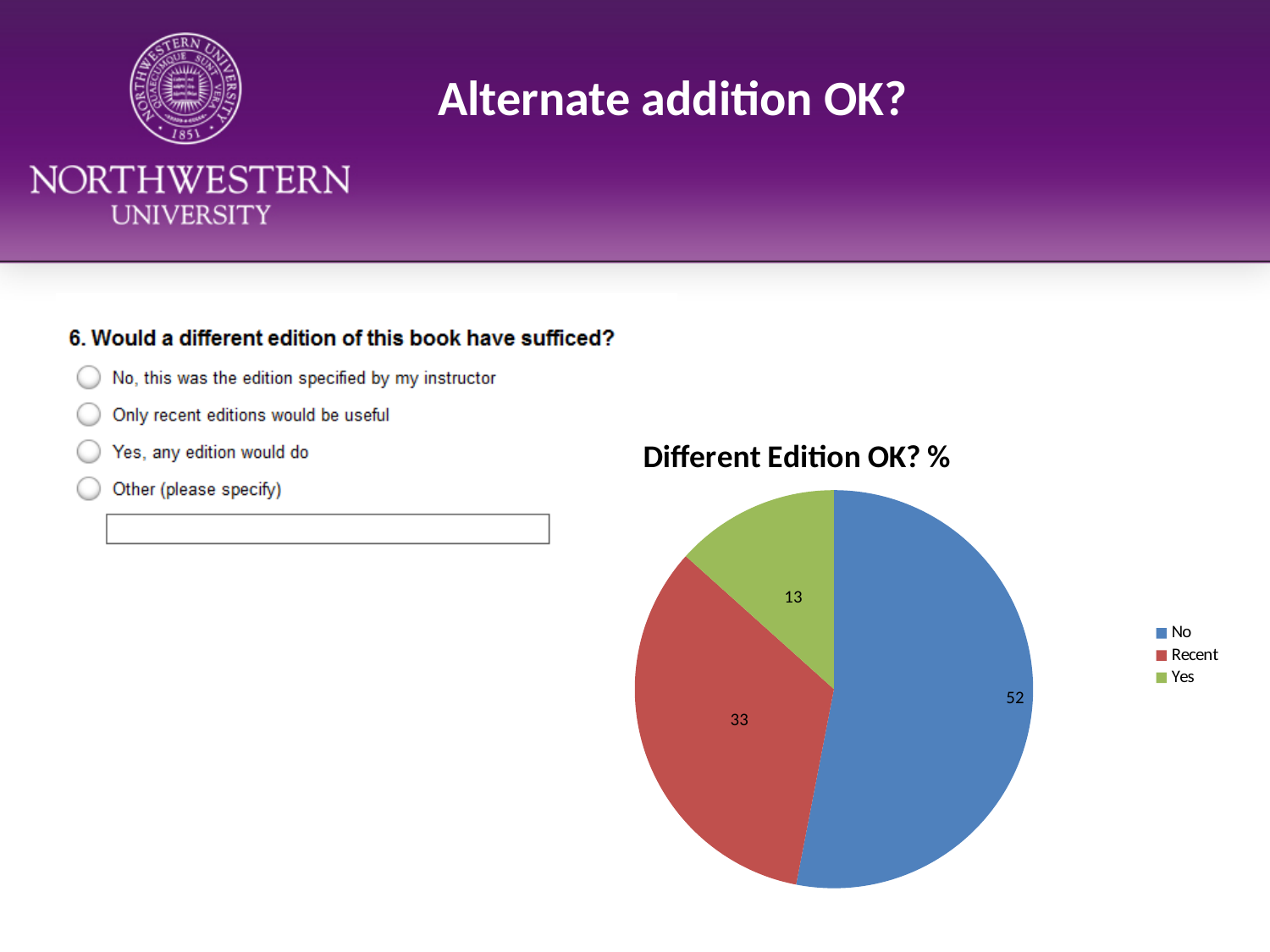
What is the value for the Recent slice in the pie chart? 33 How many slices does the pie chart have? 3 What is the value for the No slice in the pie chart? 52 What kind of chart is shown on the slide? Pie chart What is the value for the Yes slice in the pie chart? 13 Which is larger in the pie chart, Recent or Yes? Recent What is the difference between the Recent and Yes values in the pie chart? 20 Which category has the largest slice in the pie chart? No What is the title of the chart on the slide? Different Edition OK? % What colour is the Recent slice in the pie chart? Red Which category has the smallest slice in the pie chart? Yes What is the difference between the No and Recent values in the pie chart? 19